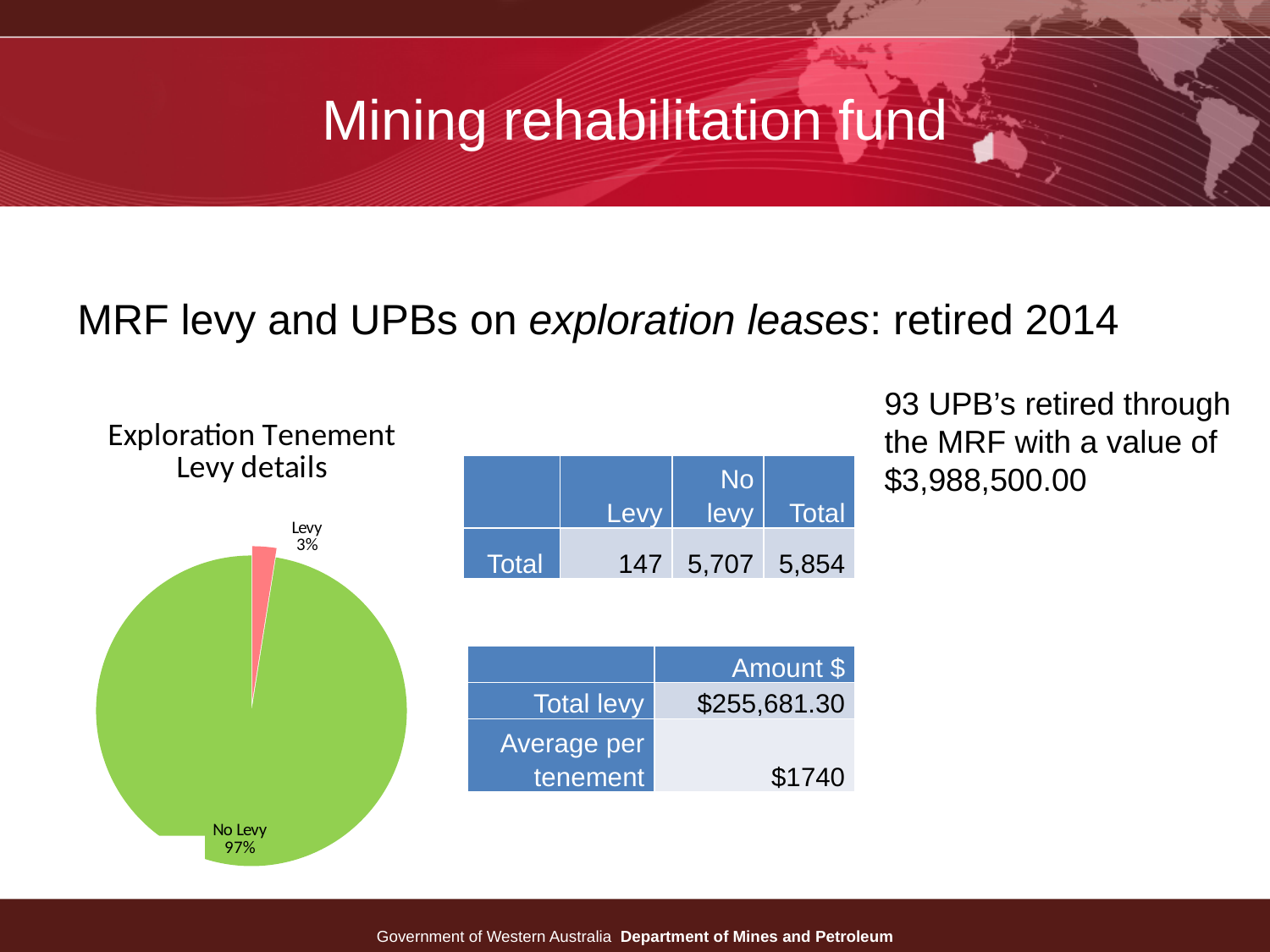
What share of the pie does the No Levy slice represent? 97% Which slice of the pie chart is the smallest? Levy Which slice of the pie chart is the largest? No Levy What share of the pie does the Levy slice represent? 3% What is the difference in percentage points between the No Levy and Levy slices? 94 Which is larger in the pie chart, the Levy slice or the No Levy slice? No Levy How many slices does the pie chart have? 2 What colour is the No Levy slice in the pie chart? green What is the title of the pie chart? Exploration Tenement Levy details What kind of chart is shown on the slide? pie chart